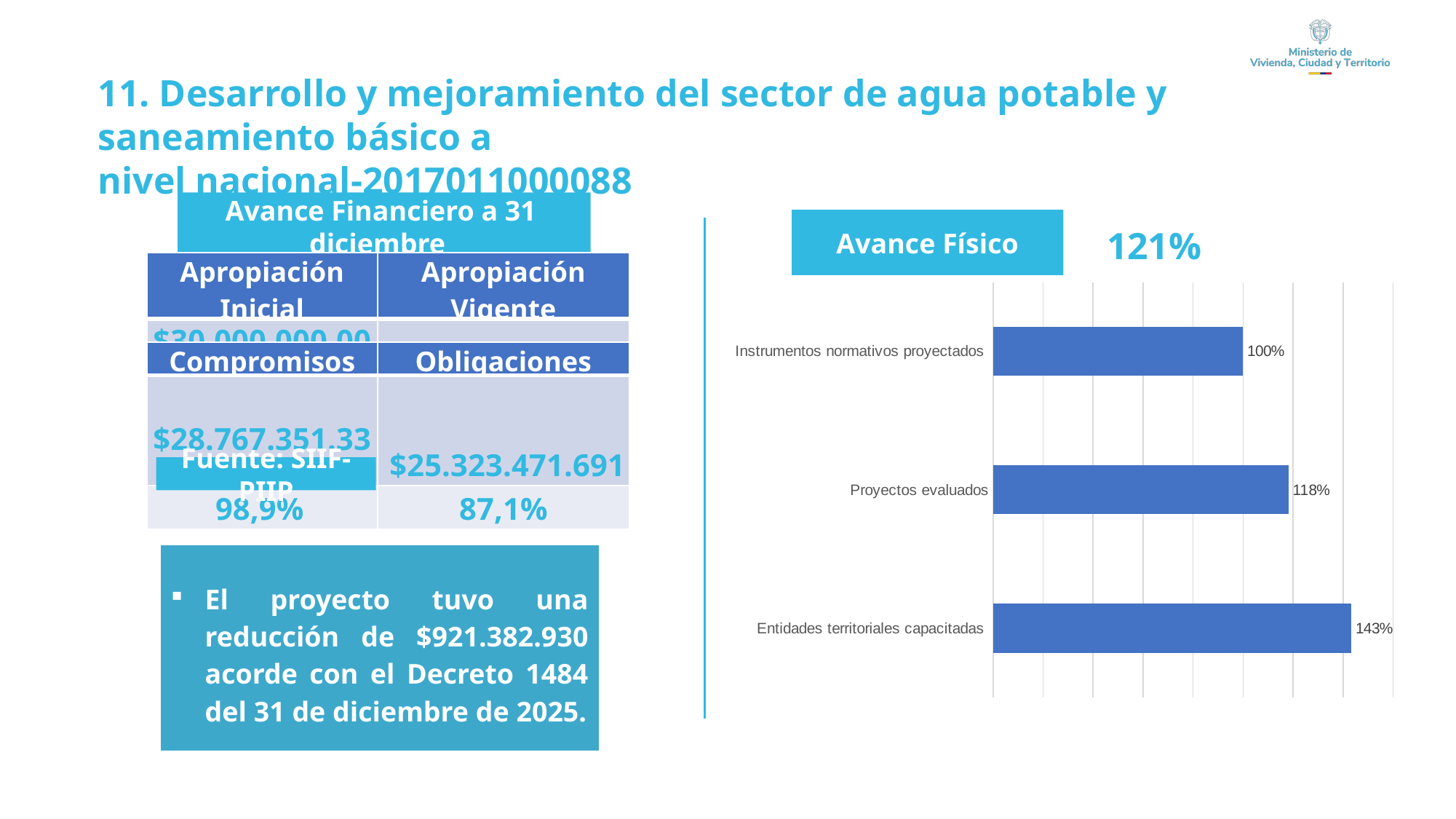
How many categories are shown in the bar chart? 3 What kind of chart is shown on the slide? Bar chart What is the difference between the values for Proyectos evaluados and Instrumentos normativos proyectados? 18% What is the value for Instrumentos normativos proyectados? 100% What colour are the bars in the chart? Blue Which is larger, the value for Proyectos evaluados or the value for Instrumentos normativos proyectados? Proyectos evaluados What is the value for Entidades territoriales capacitadas? 143% Which category has the lowest value? Instrumentos normativos proyectados What is the difference between the values for Entidades territoriales capacitadas and Proyectos evaluados? 25% What is the heading shown above the bar chart? Avance Físico Which category has the highest value? Entidades territoriales capacitadas What is the value for Proyectos evaluados? 118%